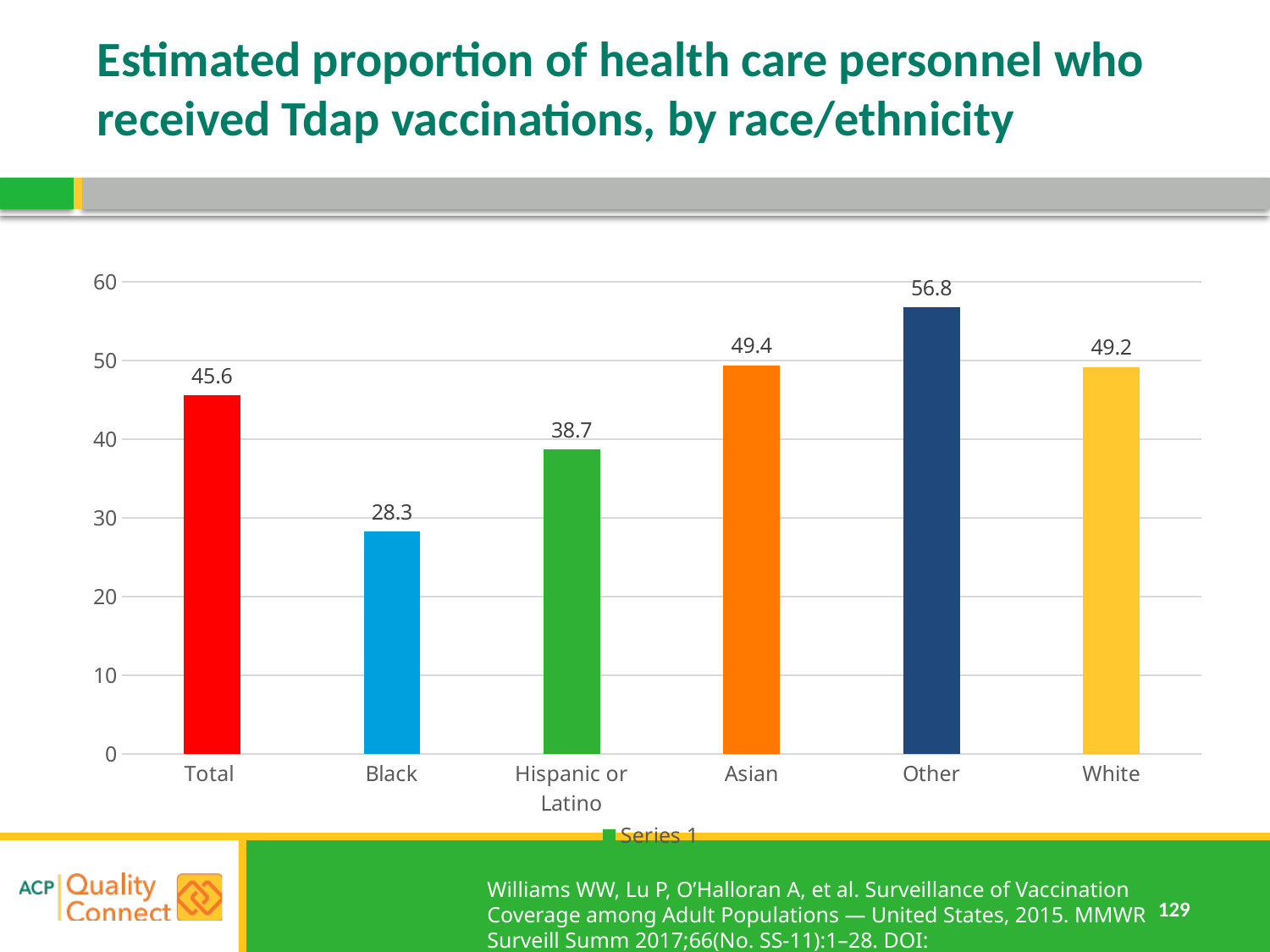
What is the difference between the values for Other and Black? 28.5 Which category has the lowest value? Black Which is larger, the value for Total or the value for Hispanic or Latino? Total What is the difference between the values for Asian and Total? 3.8 What kind of chart is shown on the slide? bar chart What is the value for Hispanic or Latino? 38.7 What is the value for Other? 56.8 Is the value for White greater or less than 40? greater What is the value for Black? 28.3 What colour is the bar for Asian? orange Which category has the highest value? Other How many categories are shown on the x axis? 6